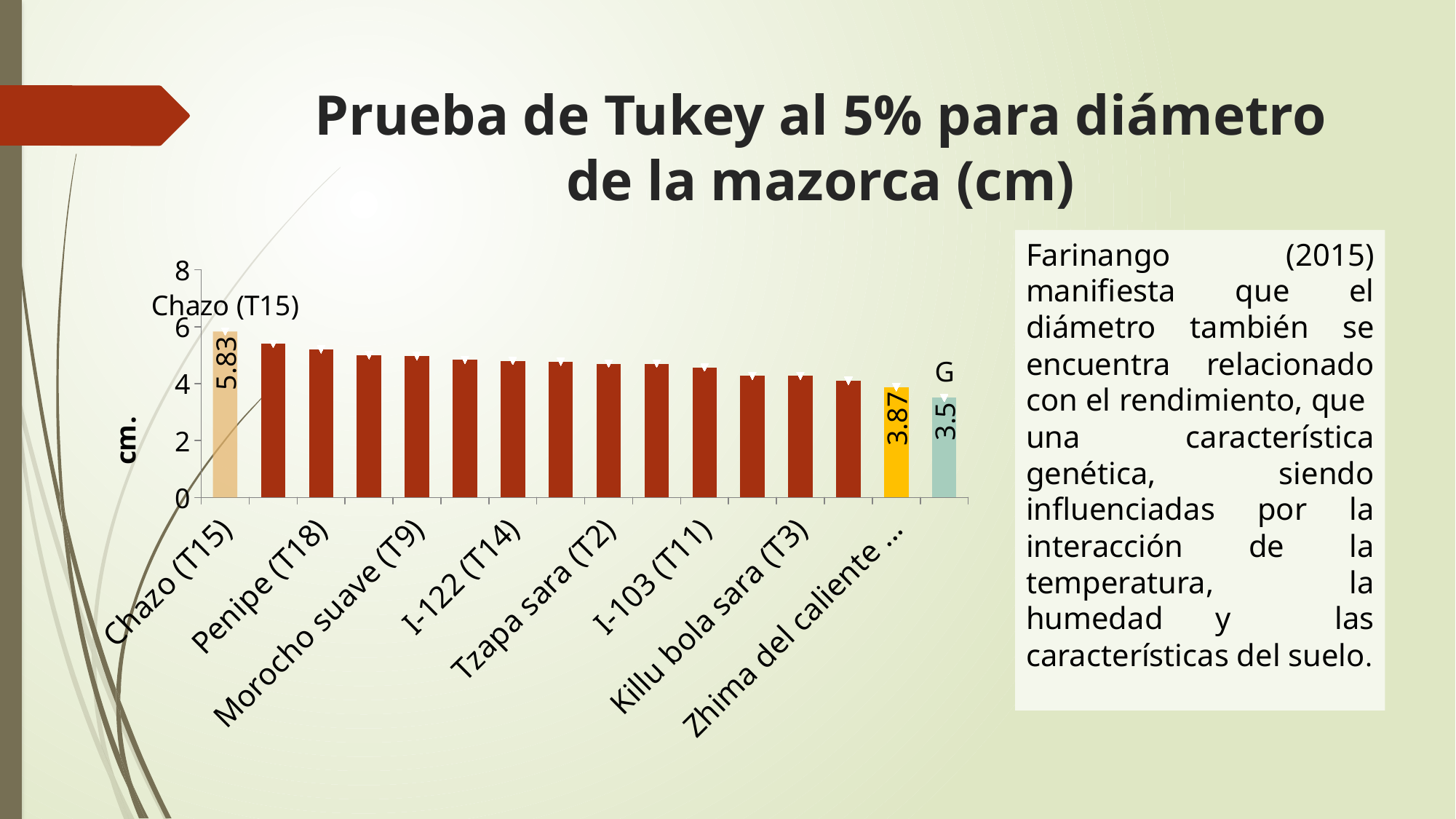
What is the value shown on the yellow bar? 3.87 What is the difference between the value for Chazo (T15) and the value of the bar labelled G? 2.33 Which category has the highest value? Chazo (T15) What is the value for Chazo (T15)? 5.83 How many bars are plotted in the chart? 16 Which is larger, the value for Penipe (T18) or the value for Killu bola sara (T3)? Penipe (T18) What is the value of the last bar, labelled G? 3.5 Is the value for Killu bola sara (T3) greater or less than 6? less Which bar has the lowest value? G What kind of chart is shown on the slide? bar chart Is the value for Penipe (T18) greater or less than 4? greater What is the difference between the value for Chazo (T15) and the value of the yellow bar? 1.96